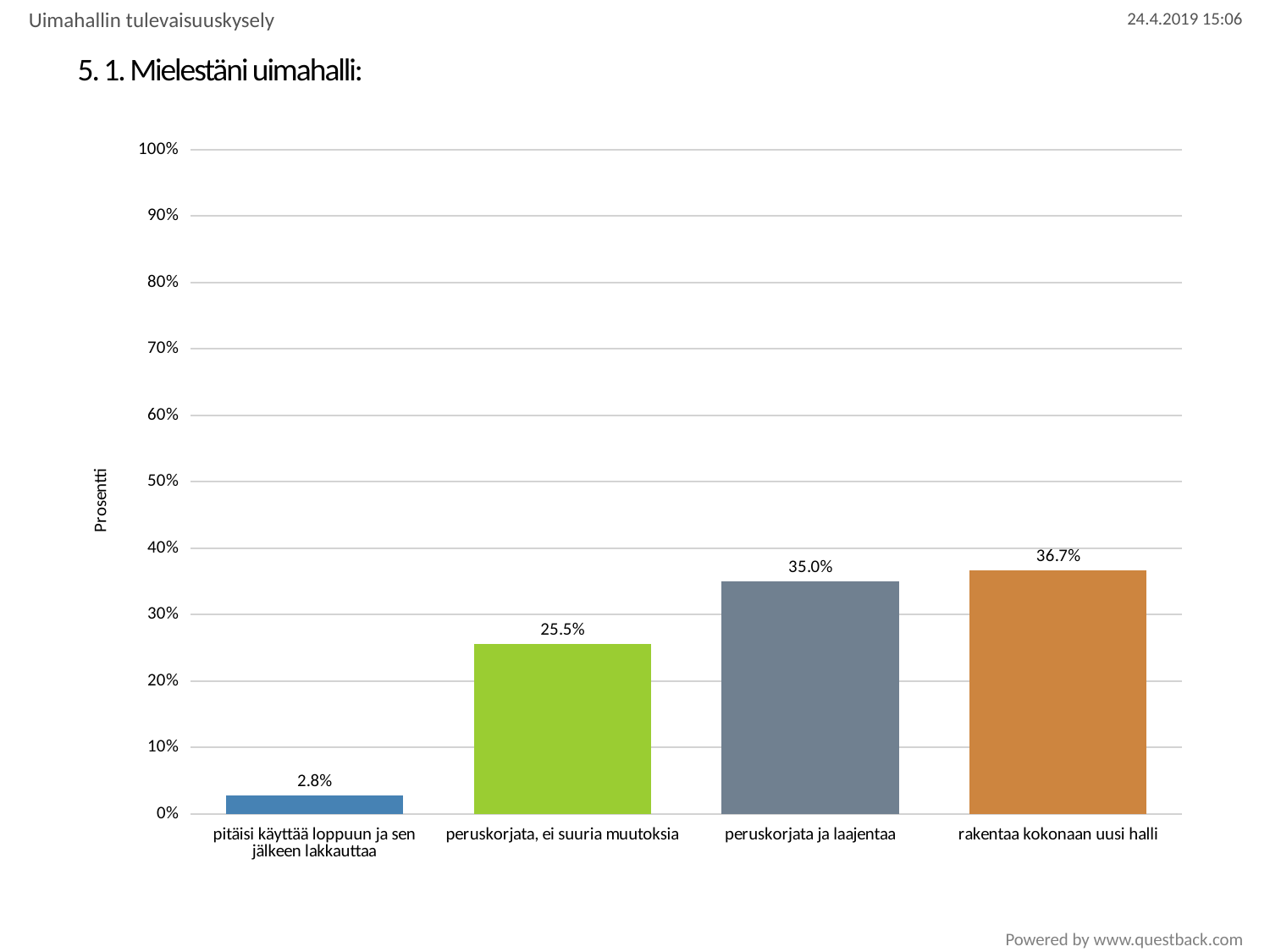
How many response options are shown in the chart? 4 What is the value for "pitäisi käyttää loppuun ja sen jälkeen lakkauttaa"? 2.8% Do the values rise or fall from left to right across the categories? rise Which option has the lowest percentage? pitäisi käyttää loppuun ja sen jälkeen lakkauttaa What is the value for "peruskorjata, ei suuria muutoksia"? 25.5% What is the label of the vertical axis? Prosentti Which is larger: the value for "peruskorjata ja laajentaa" or the value for "peruskorjata, ei suuria muutoksia"? peruskorjata ja laajentaa What type of chart is shown on the slide? bar chart What is the difference in percentage points between "peruskorjata ja laajentaa" and "peruskorjata, ei suuria muutoksia"? 9.5 What percentage of respondents chose "rakentaa kokonaan uusi halli"? 36.7% Which option has the highest percentage? rakentaa kokonaan uusi halli Is the value for "peruskorjata ja laajentaa" greater or less than 30%? greater